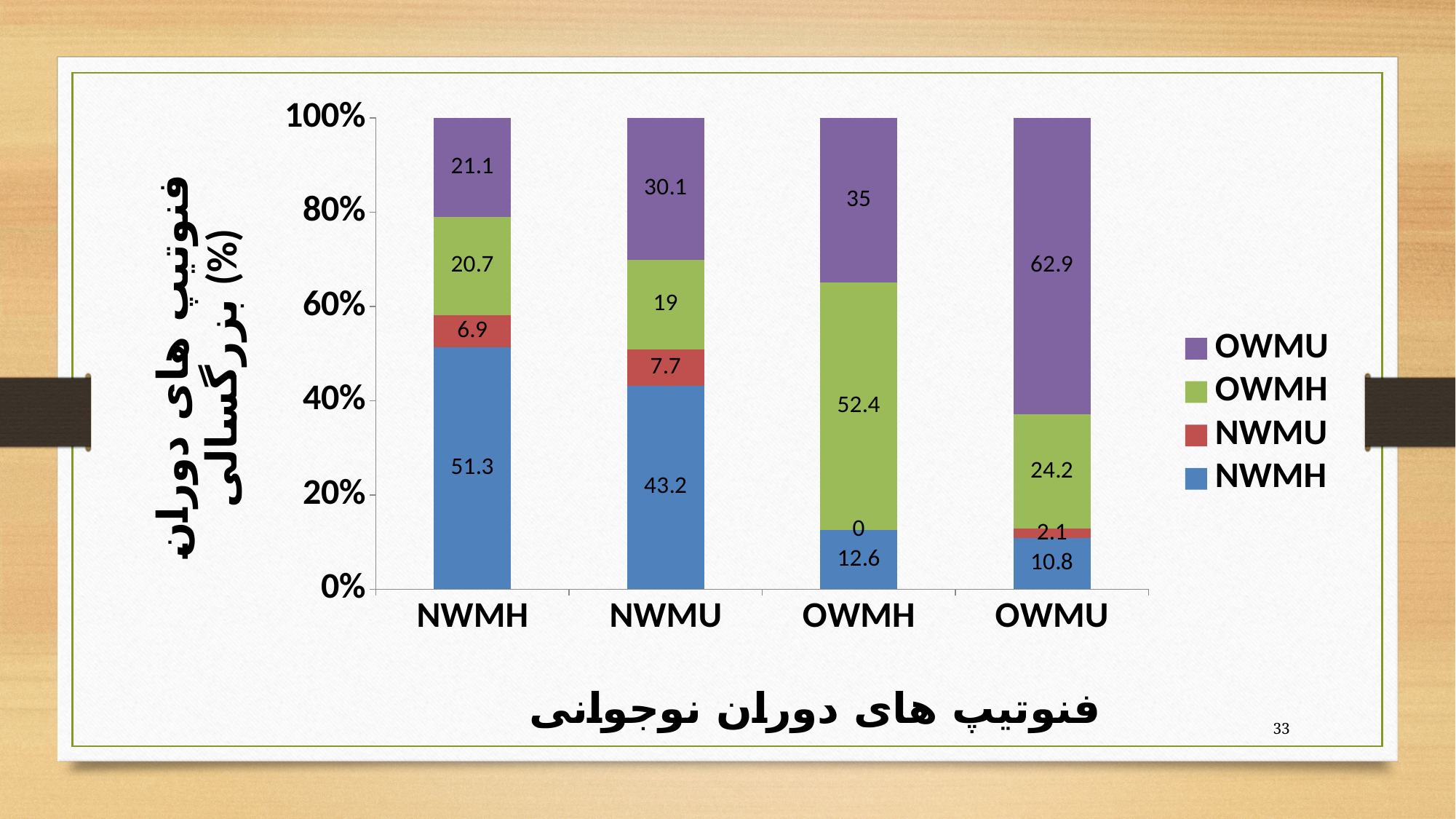
Which legend entry is shown in purple? OWMU What is the NWMU series value for the OWMH category? 0 Which category has the lowest NWMH series value? OWMU How many series does the legend list? 4 Which category has the highest OWMU series value? OWMU Which is larger: the NWMU series value for NWMH or for NWMU? NWMU What is the NWMH series value for the NWMH category? 51.3 What is the OWMH series value for the NWMU category? 19 What kind of chart is shown on the slide? stacked bar chart What is the difference between the OWMH series values for the OWMH and OWMU categories? 28.2 What is the OWMU series value for the OWMU category? 62.9 How many categories are shown on the x axis? 4